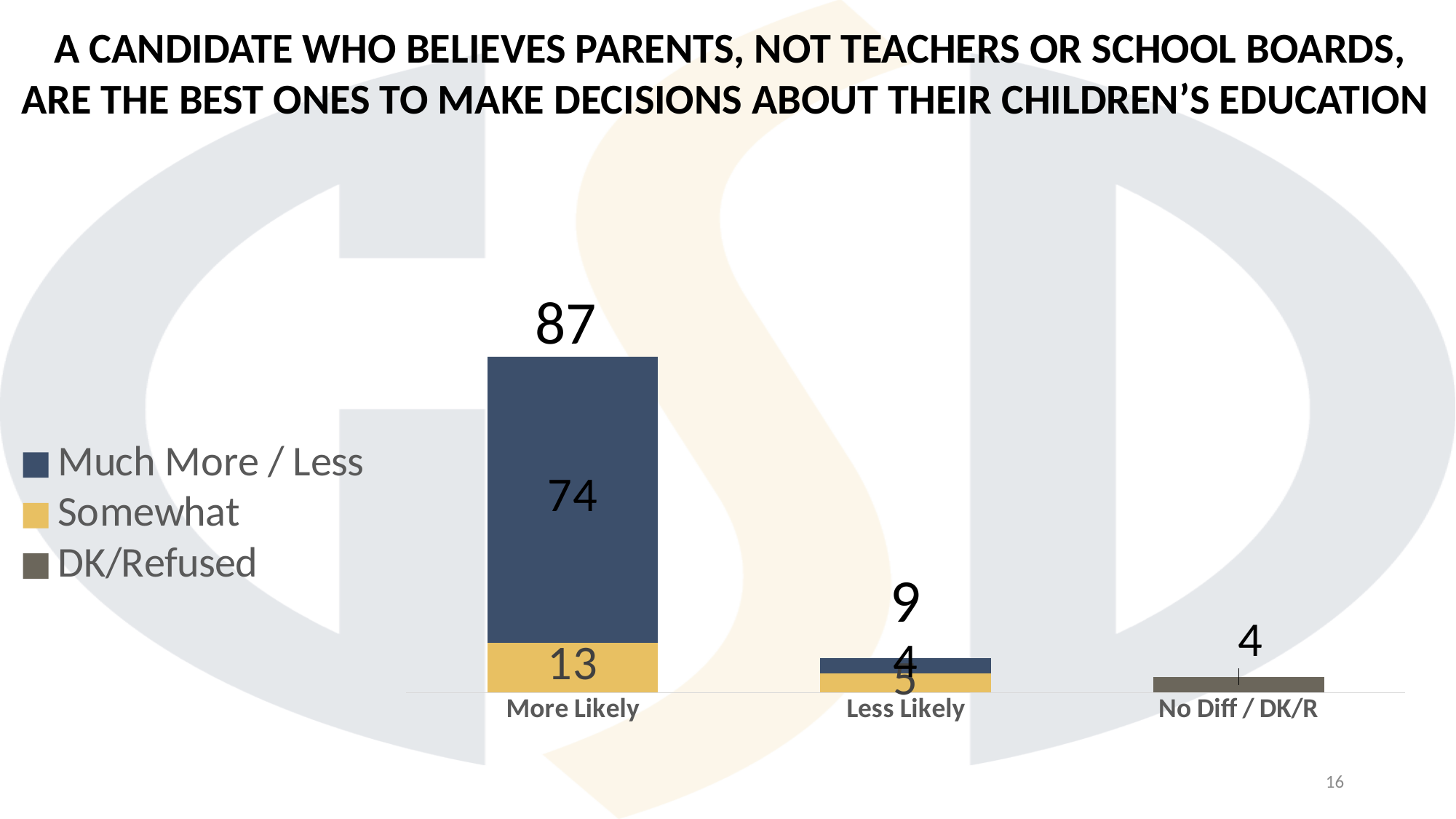
What is the value of the Much More / Less segment for Less Likely? 4 What is the value shown for No Diff / DK/R? 4 What is the total of the stacked bar for More Likely? 87 What is the value of the Somewhat segment for Less Likely? 5 Which is larger: the Much More / Less segment for More Likely or the Somewhat segment for More Likely? Much More / Less What is the value of the Somewhat segment for More Likely? 13 How many series does the legend list? 3 How many categories are shown on the x axis? 3 What is the total of the stacked bar for Less Likely? 9 What is the value of the Much More / Less segment for More Likely? 74 Which category has the highest total? More Likely What is the difference between the More Likely total and the Less Likely total? 78